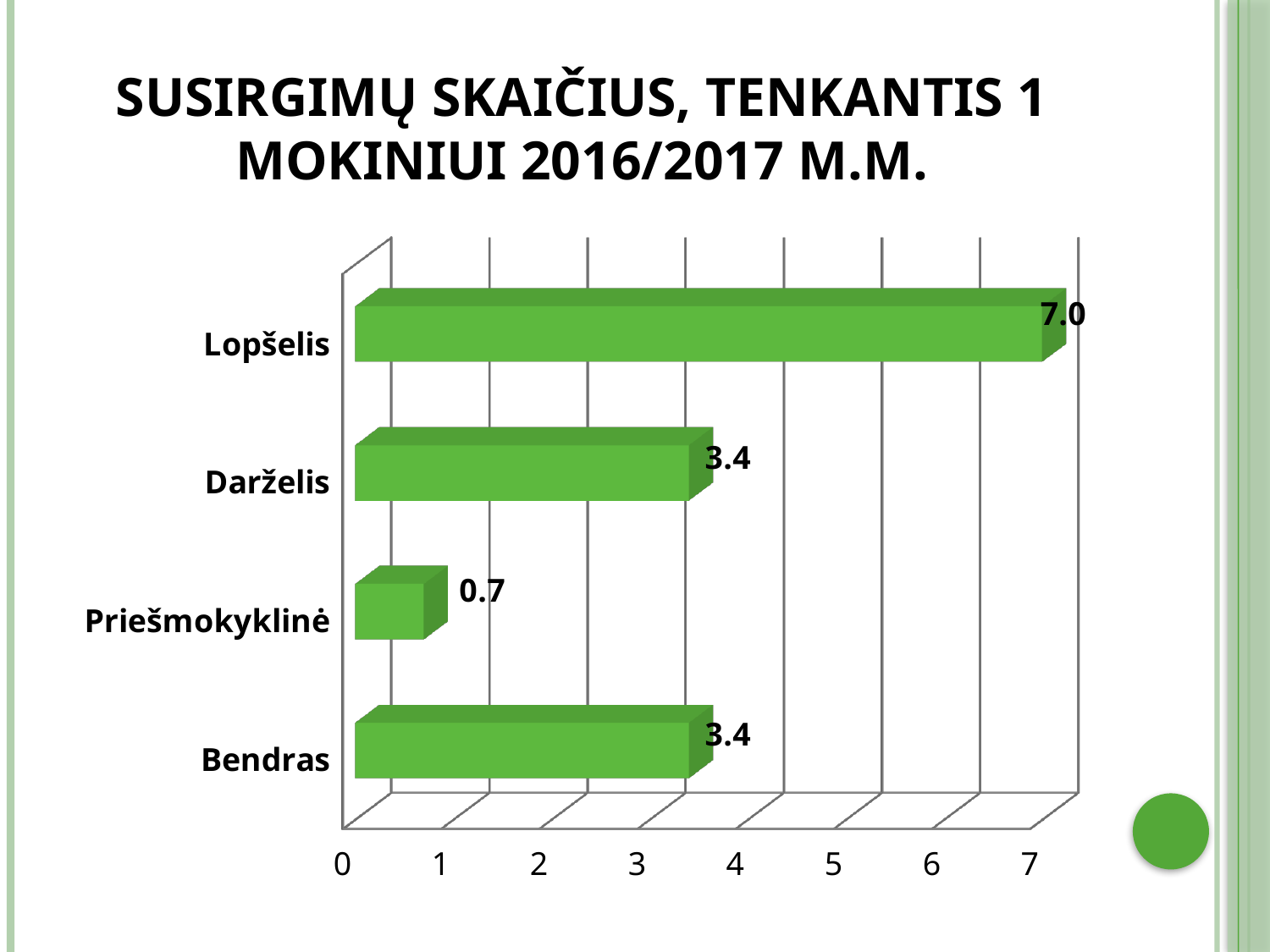
What kind of chart is shown on the slide? Bar chart What is the value for Priešmokyklinė? 0.7 What is the difference between the values for Darželis and Priešmokyklinė? 2.7 How many categories are shown in the chart? 4 What is the value for Bendras? 3.4 What is the title of the chart? SUSIRGIMŲ SKAIČIUS, TENKANTIS 1 MOKINIUI 2016/2017 M.M. Which category has the highest value? Lopšelis What is the difference between the values for Lopšelis and Darželis? 3.6 What is the value for Lopšelis? 7.0 What is the value for Darželis? 3.4 Which category has the lowest value? Priešmokyklinė Which is larger, the value for Lopšelis or the value for Bendras? Lopšelis